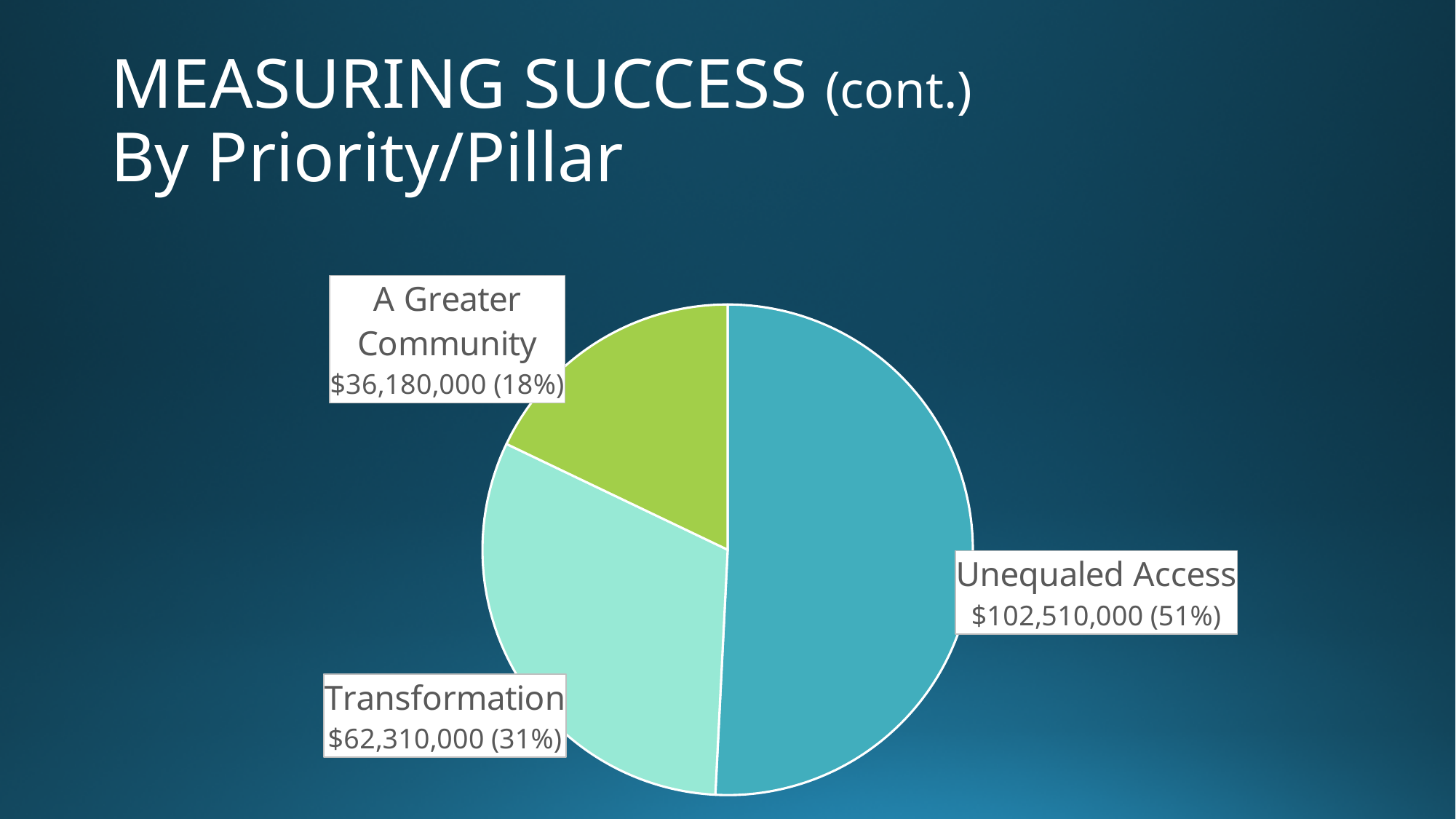
Which pillar has the smallest slice of the pie? A Greater Community What kind of chart is shown on the slide? pie chart How many slices does the pie chart have? 3 What is the value for Unequaled Access? $102,510,000 What is the value for Transformation? $62,310,000 What colour is the Unequaled Access slice? teal blue What share of the pie does A Greater Community represent? 18% Which pillar has the largest slice of the pie? Unequaled Access What is the value for A Greater Community? $36,180,000 Which is larger, the value for Transformation or the value for A Greater Community? Transformation What share of the pie does Transformation represent? 31% What is the difference between the values for Unequaled Access and Transformation? $40,200,000